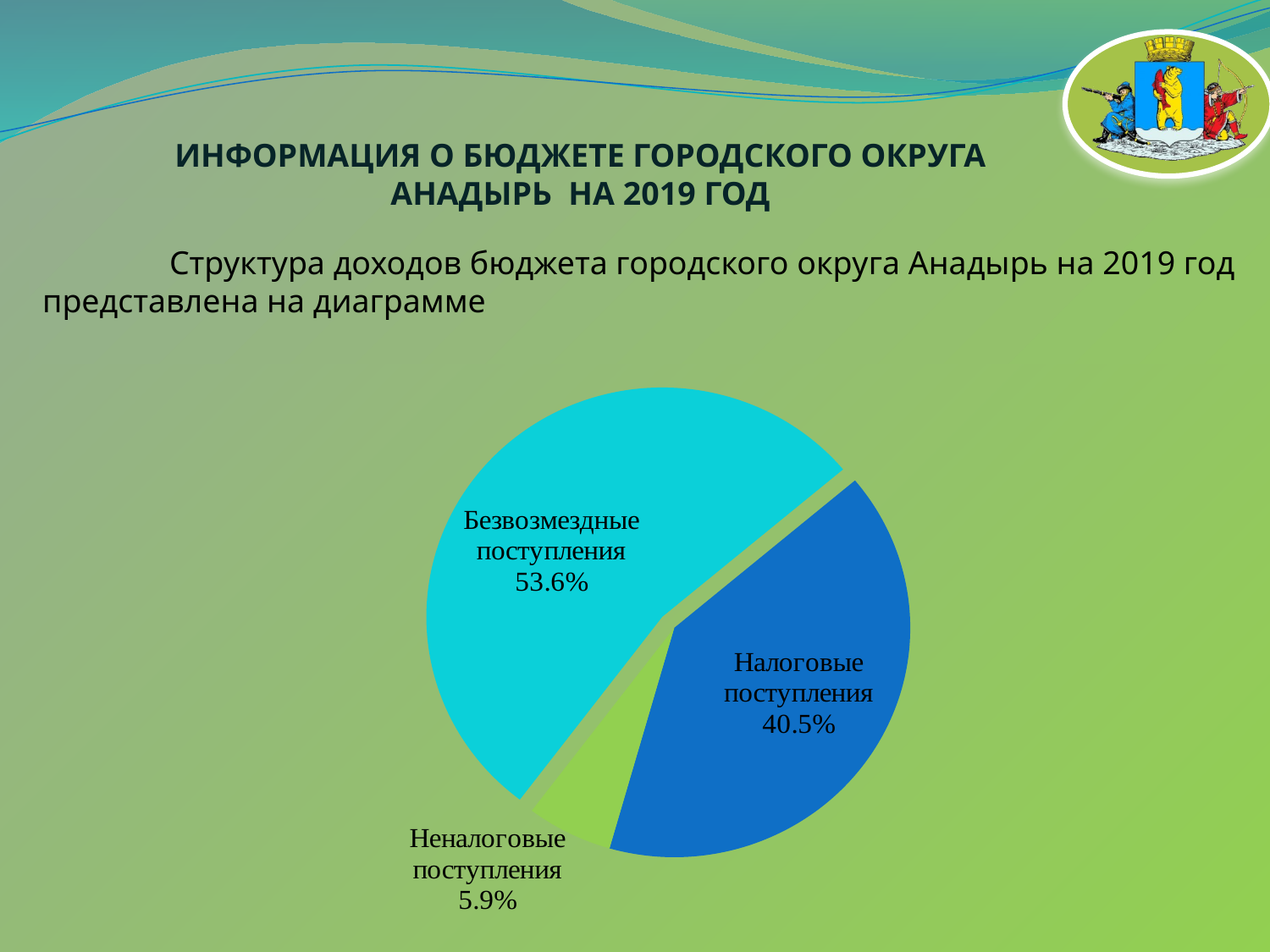
What share of the pie is labelled Налоговые поступления? 40.5% Which slice of the pie is the smallest? Неналоговые поступления What share of the pie is labelled Безвозмездные поступления? 53.6% What is the difference in percentage points between Налоговые поступления and Неналоговые поступления? 34.6 How many slices does the pie chart have? 3 What colour is the slice for Налоговые поступления? dark blue Which is larger, the share for Налоговые поступления or the share for Неналоговые поступления? Налоговые поступления What is the difference in percentage points between Безвозмездные поступления and Налоговые поступления? 13.1 Which slice of the pie is the largest? Безвозмездные поступления What share of the pie is labelled Неналоговые поступления? 5.9% What colour is the slice for Неналоговые поступления? green What kind of chart is shown on the slide? pie chart